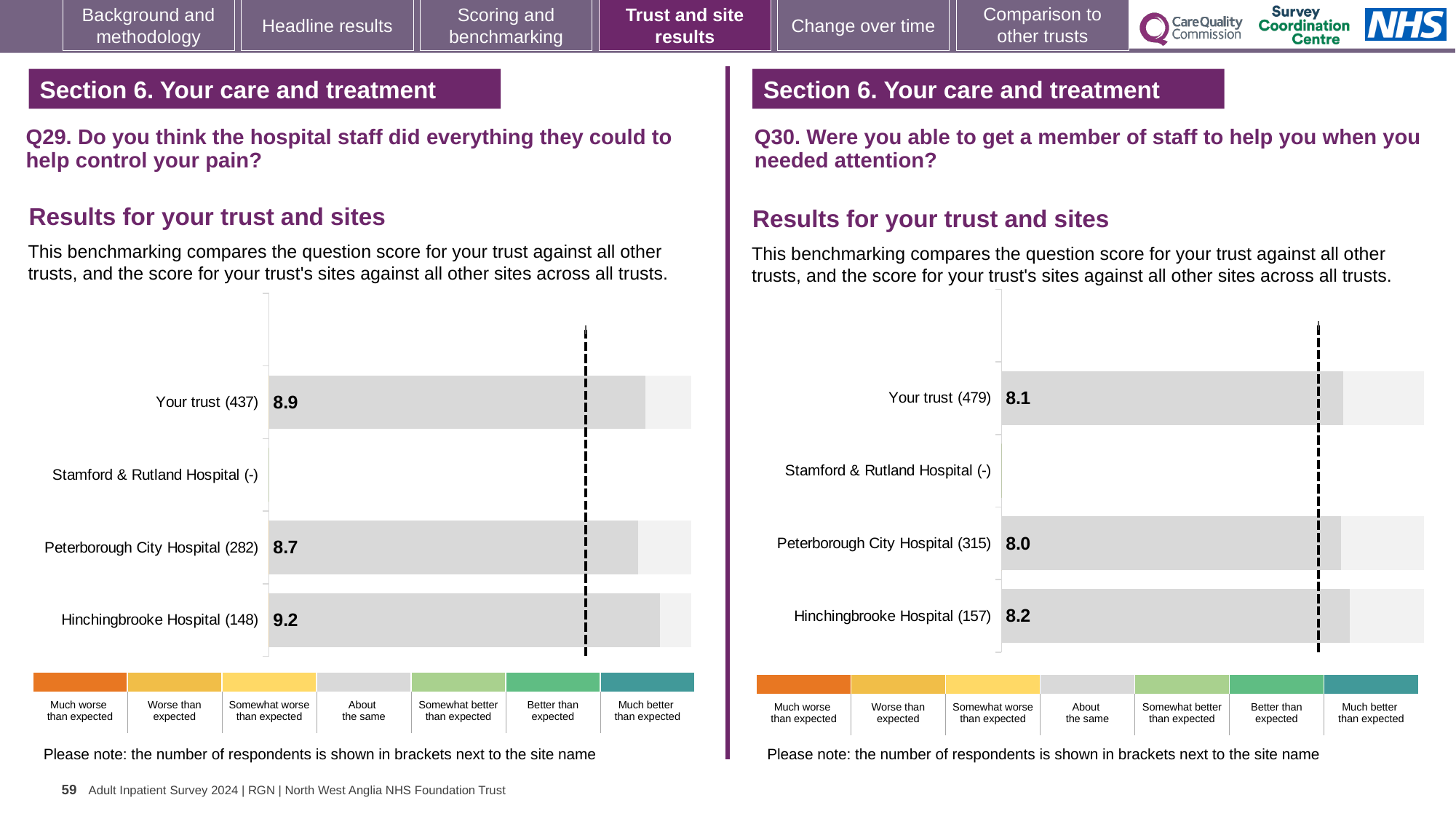
On the Q29 chart (left), how many respondents are shown in brackets for Your trust? 437 On the Q30 chart (right), what is the difference between the scores for Your trust and Peterborough City Hospital? 0.1 On the Q29 chart (left), what is the score for Your trust? 8.9 On the Q29 chart (left), which site has the highest score? Hinchingbrooke Hospital On the Q30 chart (right), what is the score for Hinchingbrooke Hospital? 8.2 On the Q29 chart (left), what is the difference between the scores for Hinchingbrooke Hospital and Peterborough City Hospital? 0.5 What kind of chart is used on the Q29 chart (left)? Bar chart On the Q30 chart (right), what is the score for Peterborough City Hospital? 8.0 On the Q29 chart (left), what is the score for Hinchingbrooke Hospital? 9.2 On the Q30 chart (right), what is the score for Your trust? 8.1 On the Q30 chart (right), which of Peterborough City Hospital or Hinchingbrooke Hospital has the higher score? Hinchingbrooke Hospital On the Q29 chart (left), what is the score for Peterborough City Hospital? 8.7